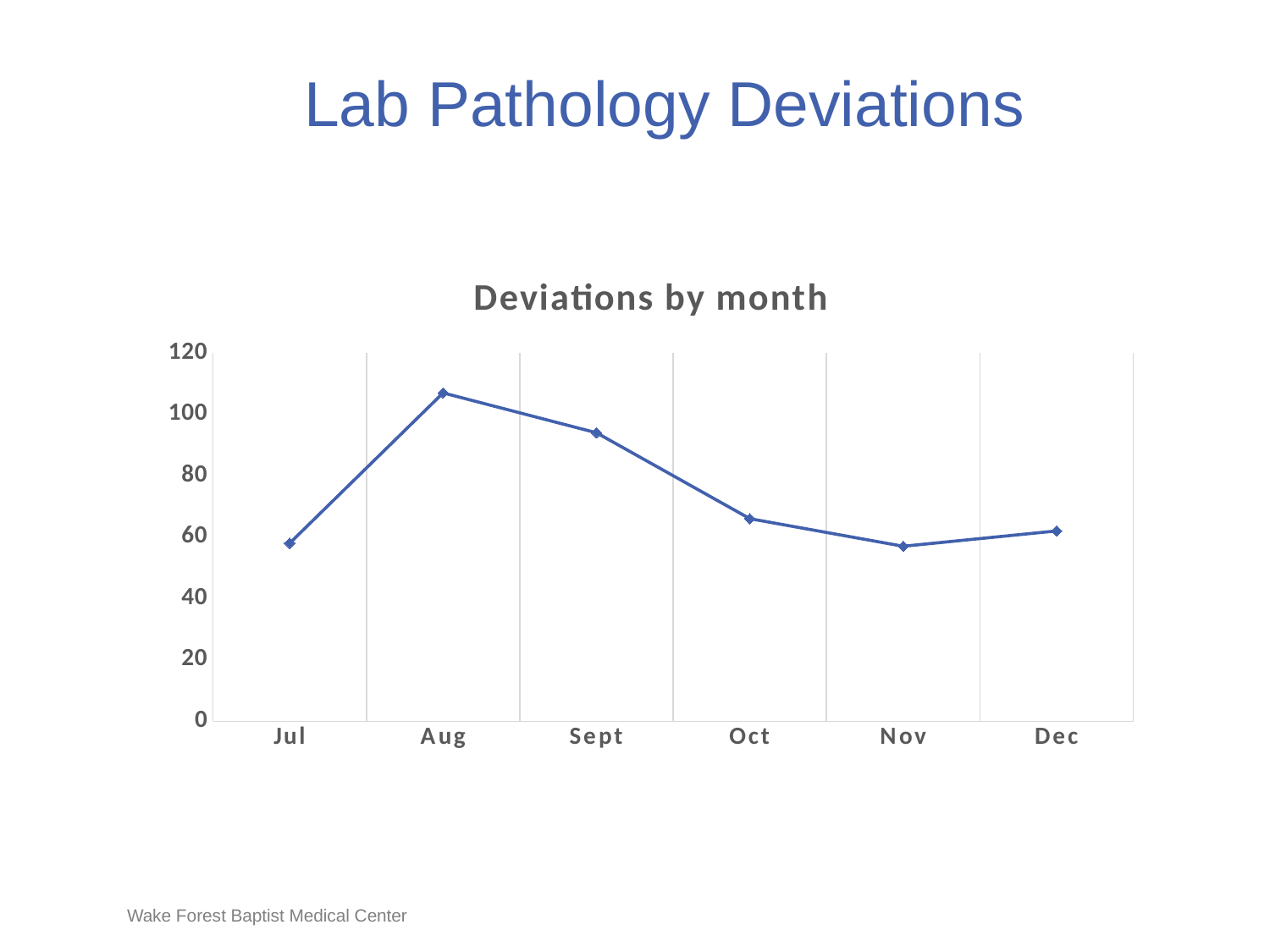
Do the deviations rise or fall from Aug to Nov? fall Which is larger, the value for Aug or the value for Sept? Aug Which is larger, the value for Jul or the value for Aug? Aug Is the value for Aug greater or less than 100? greater Is the value for Oct greater or less than 80? less What kind of chart is shown on the slide? Line chart What is the title of the chart? Deviations by month Which month has the highest number of deviations? Aug How many months are plotted on the x axis? 6 Is the value for Sept greater or less than 80? greater